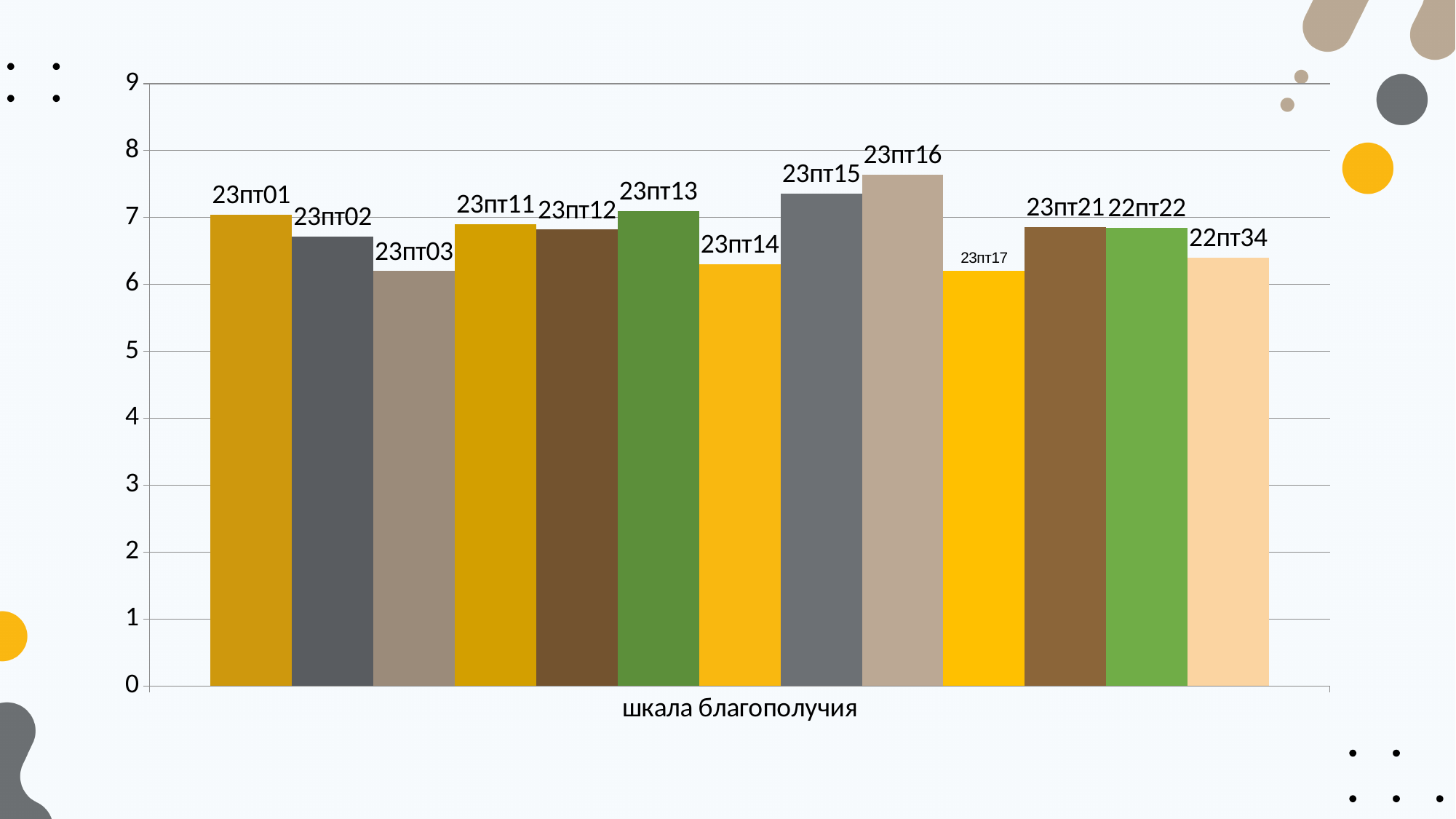
Is the value for 23пт15 greater or less than 7? greater What kind of chart is shown on the slide? bar chart How many bars are plotted in the chart? 13 Is the value for 23пт17 greater or less than 6? greater Is the value for 23пт03 greater or less than 7? less Which is larger, the value for 23пт15 or the value for 23пт14? 23пт15 Which bar is the highest in the chart? 23пт16 What label is shown on the horizontal axis of the chart? шкала благополучия Which is larger, the value for 23пт16 or the value for 23пт03? 23пт16